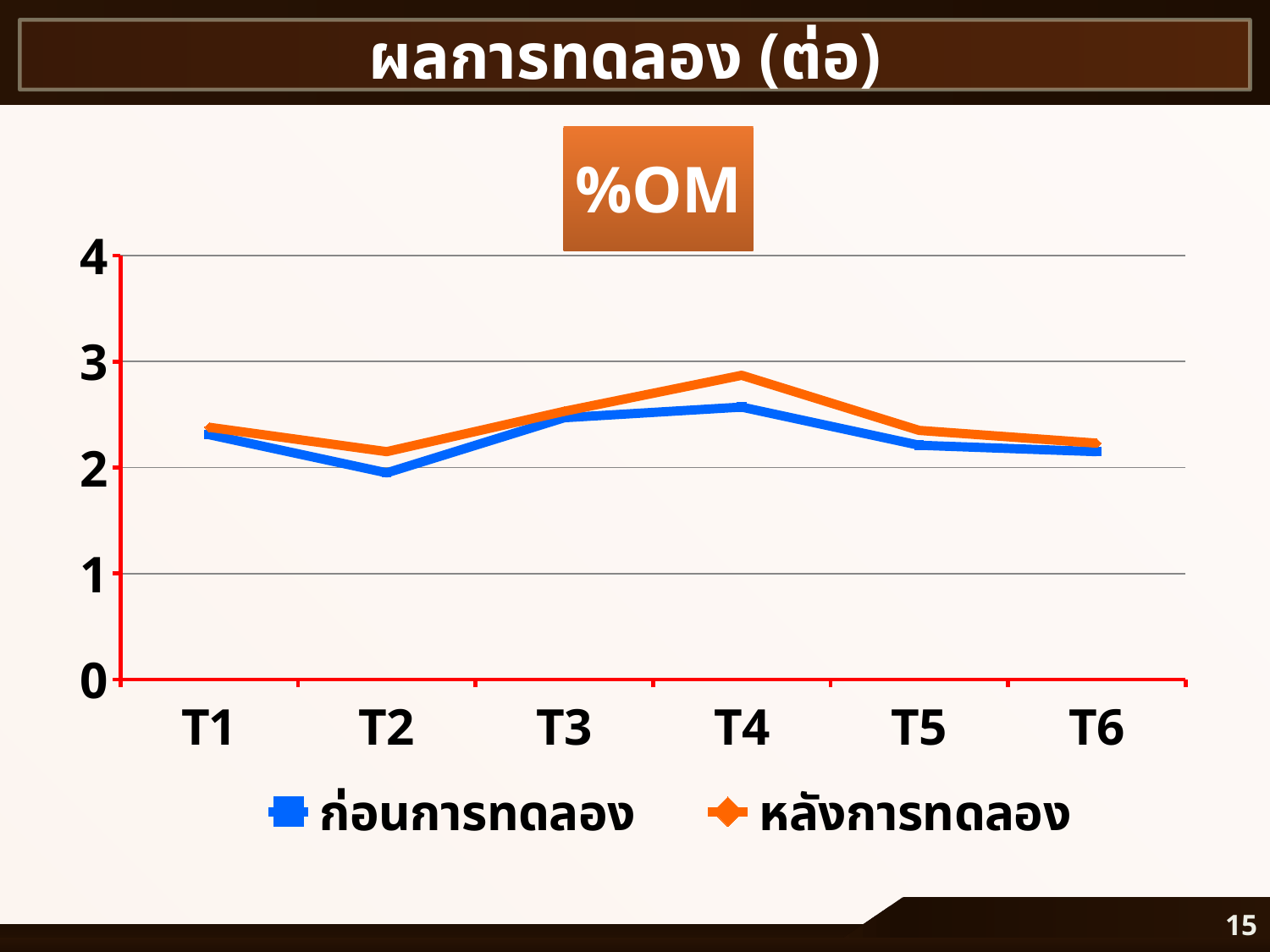
What kind of chart is shown on the slide? line chart What is the title of the chart? %OM Do the values for ก่อนการทดลอง rise or fall from T2 to T4? rise Is the value for หลังการทดลอง at T1 greater or less than 2? greater Which category has the lowest value for ก่อนการทดลอง? T2 Which category has the lowest value for หลังการทดลอง? T2 How many categories are shown on the x axis? 6 Which category has the highest value for หลังการทดลอง? T4 Is the value for หลังการทดลอง at T4 greater or less than 3? less How many series does the legend list? 2 At T4, which series has the larger value, ก่อนการทดลอง or หลังการทดลอง? หลังการทดลอง